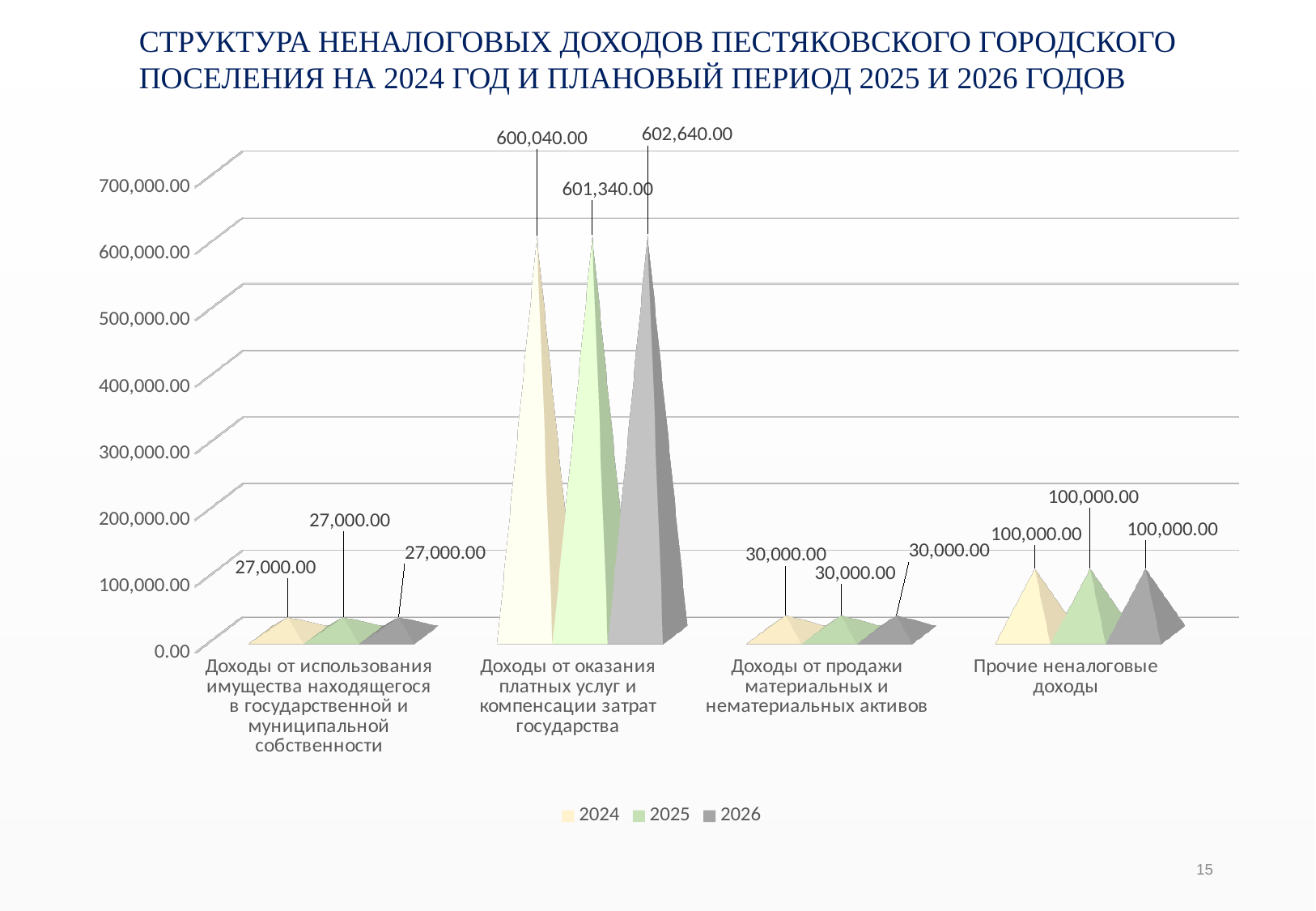
What kind of chart is shown on the slide? Bar chart Which category has the highest value in 2025? Доходы от оказания платных услуг и компенсации затрат государства Which category has the lowest value in 2026? Доходы от использования имущества находящегося в государственной и муниципальной собственности What is the 2024 value for «Доходы от продажи материальных и нематериальных активов»? 30,000.00 What is the 2025 value for «Прочие неналоговые доходы»? 100,000.00 Which is larger: the 2024 value for «Прочие неналоговые доходы» or the 2024 value for «Доходы от продажи материальных и нематериальных активов»? Прочие неналоговые доходы What is the 2026 value for «Доходы от оказания платных услуг и компенсации затрат государства»? 602,640.00 How many series does the legend list? 3 What is the 2024 value for «Доходы от оказания платных услуг и компенсации затрат государства»? 600,040.00 What is the difference between the 2026 and 2024 values for «Доходы от оказания платных услуг и компенсации затрат государства»? 2,600.00 How many categories are shown on the x axis? 4 Which years are listed in the legend? 2024, 2025, 2026